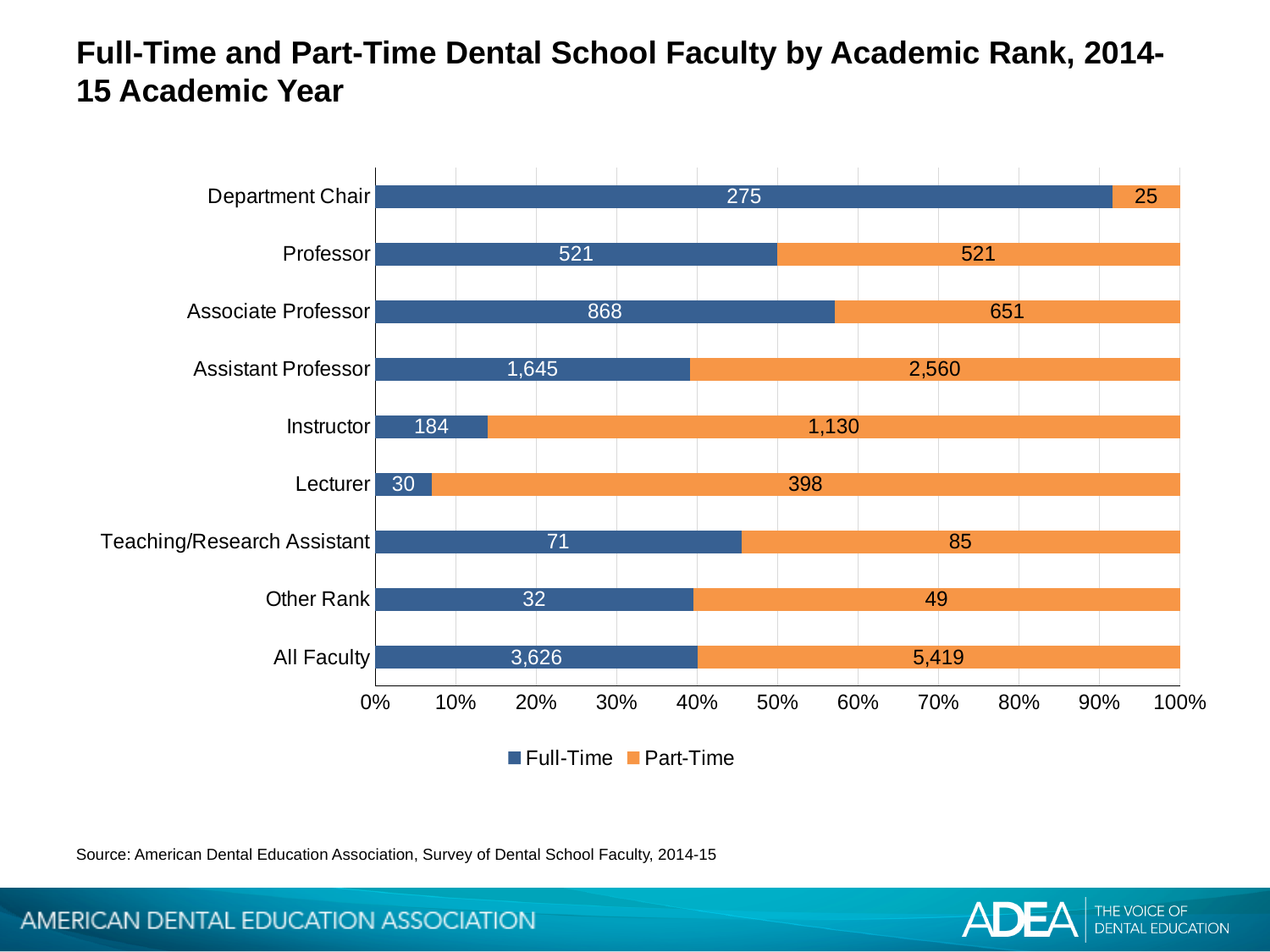
Is the Full-Time share of the Instructor bar greater or less than 20%? less What is the Part-Time value for Department Chair? 25 What is the difference between the Part-Time and Full-Time values for Assistant Professor? 915 What is the Part-Time value for Instructor? 1,130 What is the total of the Full-Time and Part-Time values for Associate Professor? 1,519 How many series does the legend list? 2 Which category has the lowest Full-Time value? Lecturer What kind of chart is shown on the slide? Stacked bar chart How many academic rank categories are shown on the chart? 9 What is the Full-Time value for Assistant Professor? 1,645 Which is larger, the Part-Time value for Instructor or the Part-Time value for Lecturer? Instructor Which category has the highest Part-Time value? All Faculty